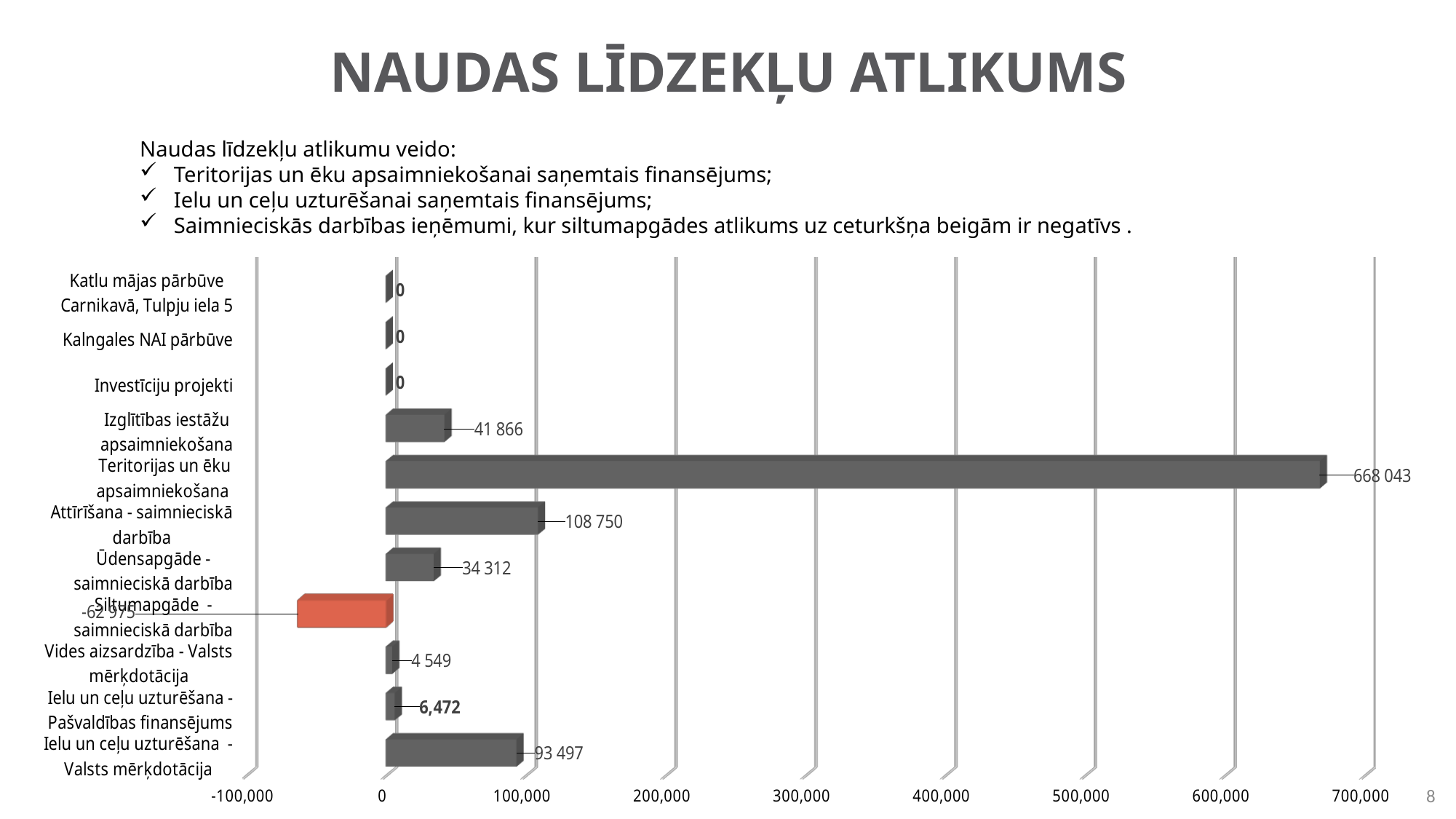
What is the value for Teritorijas un ēku apsaimniekošana? 668 043 How many categories are shown in the chart? 11 Is the value for Teritorijas un ēku apsaimniekošana greater or less than 600,000? greater Which is larger: Attīrīšana - saimnieciskā darbība or Ūdensapgāde - saimnieciskā darbība? Attīrīšana - saimnieciskā darbība Which category has the lowest value? Siltumapgāde - saimnieciskā darbība What is the difference between Attīrīšana - saimnieciskā darbība and Ielu un ceļu uzturēšana - Valsts mērķdotācija? 15 253 Which category has the highest value? Teritorijas un ēku apsaimniekošana What is the value for Ielu un ceļu uzturēšana - Valsts mērķdotācija? 93 497 What is the value for Vides aizsardzība - Valsts mērķdotācija? 4 549 What kind of chart is shown on the slide? bar chart What is the difference between Izglītības iestāžu apsaimniekošana and Ūdensapgāde - saimnieciskā darbība? 7 554 What is the value for Attīrīšana - saimnieciskā darbība? 108 750